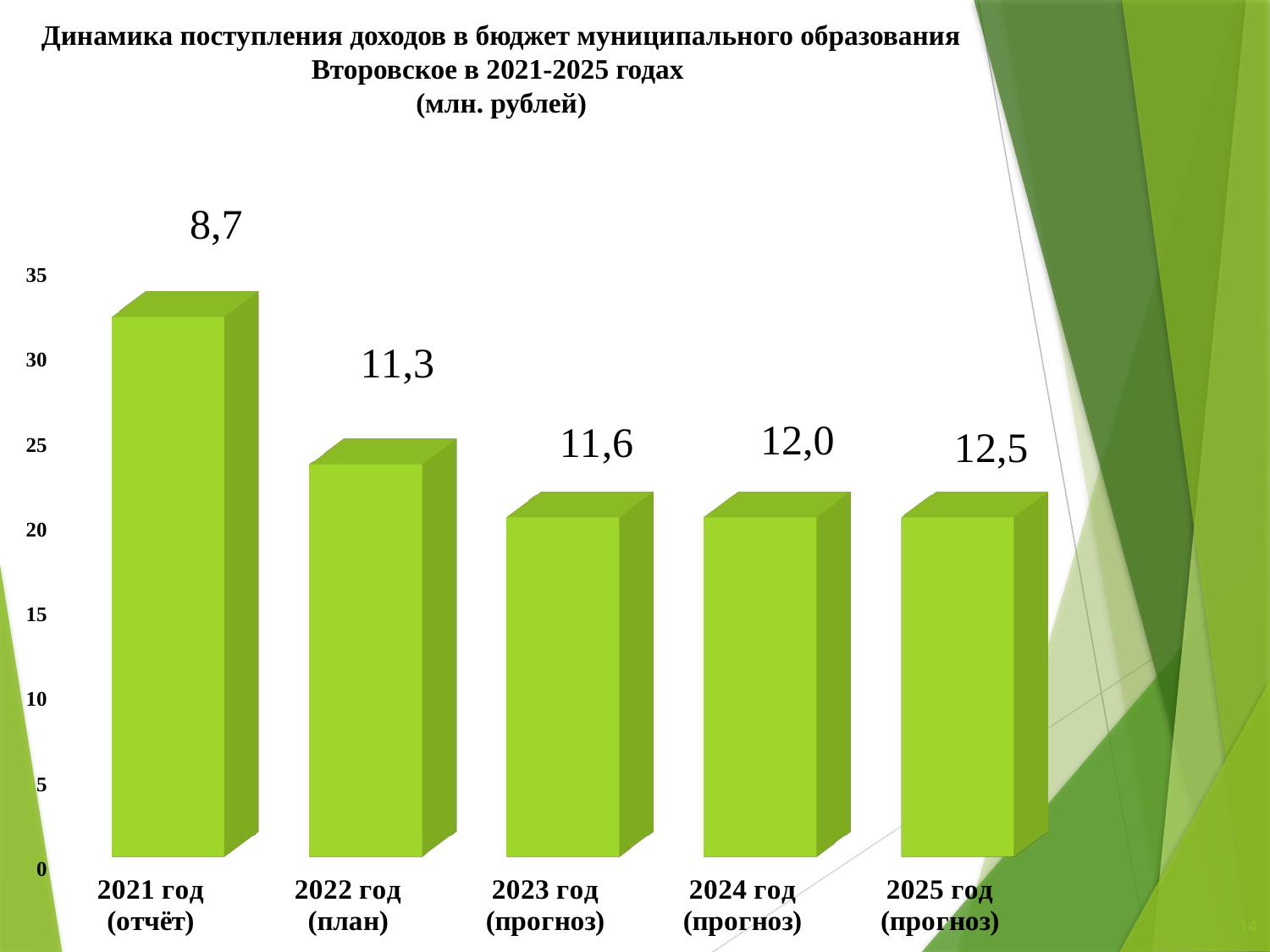
What is the value shown for 2024 год (прогноз)? 12,0 In what units are the values on the chart expressed, according to the title? млн. рублей Which year is labelled as 'отчёт' on the x axis? 2021 год What is the value shown for 2023 год (прогноз)? 11,6 How many years (categories) are shown on the chart? 5 What is the value shown for 2021 год (отчёт)? 8,7 What is the value shown for 2025 год (прогноз)? 12,5 What is the difference between the labelled values for 2025 год (прогноз) and 2021 год (отчёт)? 3,8 What is the difference between the labelled values for 2022 год (план) and 2021 год (отчёт)? 2,6 What is the value shown for 2022 год (план)? 11,3 What is the difference between the labelled values for 2024 год (прогноз) and 2023 год (прогноз)? 0,4 What kind of chart is shown on the slide? Bar chart